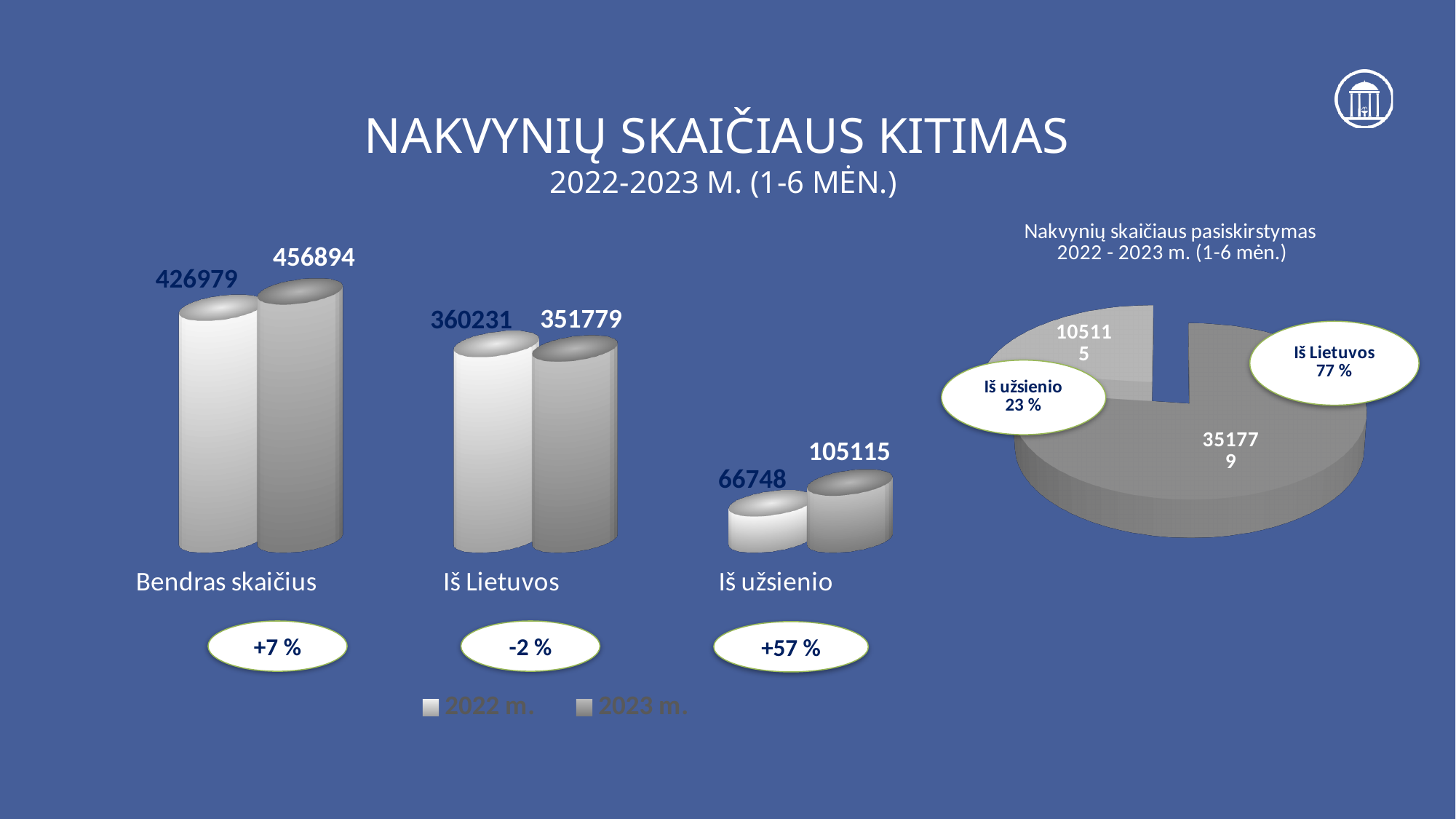
In the bar chart on the left, what is the value for Iš Lietuvos in 2023 m.? 351779 What type of chart is the chart on the right of the slide? Pie chart In the bar chart on the left, which category has the highest value for 2023 m.? Bendras skaičius In the bar chart on the left, which category has the lowest value for 2022 m.? Iš užsienio How many series does the legend of the bar chart on the left list? 2 In the pie chart on the right, what is the value of the Iš užsienio slice? 105115 In the bar chart on the left, what is the difference between the 2023 m. and 2022 m. values for Iš užsienio? 38367 How many categories does the bar chart on the left show? 3 In the bar chart on the left, what is the value for Bendras skaičius in 2023 m.? 456894 In the bar chart on the left, what is the value for Iš užsienio in 2022 m.? 66748 In the bar chart on the left, which is larger for Iš Lietuvos: the 2022 m. value or the 2023 m. value? 2022 m. In the pie chart on the right, what share does Iš Lietuvos have? 77 %